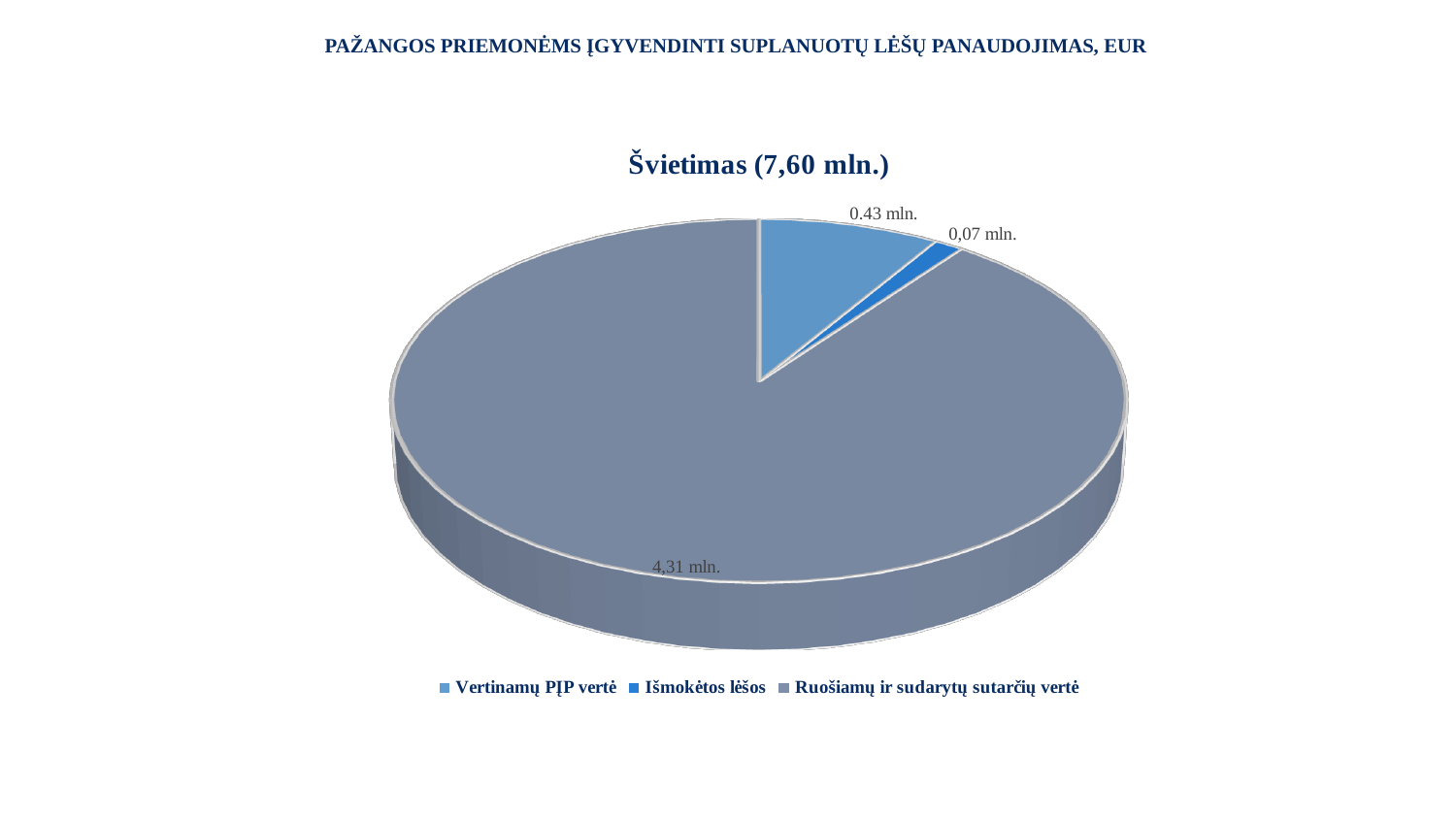
What is the value for Išmokėtos lėšos? 0,07 mln. What is the value for Ruošiamų ir sudarytų sutarčių vertė? 4,31 mln. Which category has the largest slice of the pie? Ruošiamų ir sudarytų sutarčių vertė What is the difference between Ruošiamų ir sudarytų sutarčių vertė and Vertinamų PĮP vertė? 3,88 mln. How many slices does the pie chart have? 3 How many entries does the legend list? 3 Which category has the smallest slice of the pie? Išmokėtos lėšos What is the title at the top of the slide? PAŽANGOS PRIEMONĖMS ĮGYVENDINTI SUPLANUOTŲ LĖŠŲ PANAUDOJIMAS, EUR What is the value for Vertinamų PĮP vertė? 0.43 mln. What is the title of the pie chart? Švietimas (7,60 mln.) Which is larger, Vertinamų PĮP vertė or Išmokėtos lėšos? Vertinamų PĮP vertė What kind of chart is shown on the slide? Pie chart